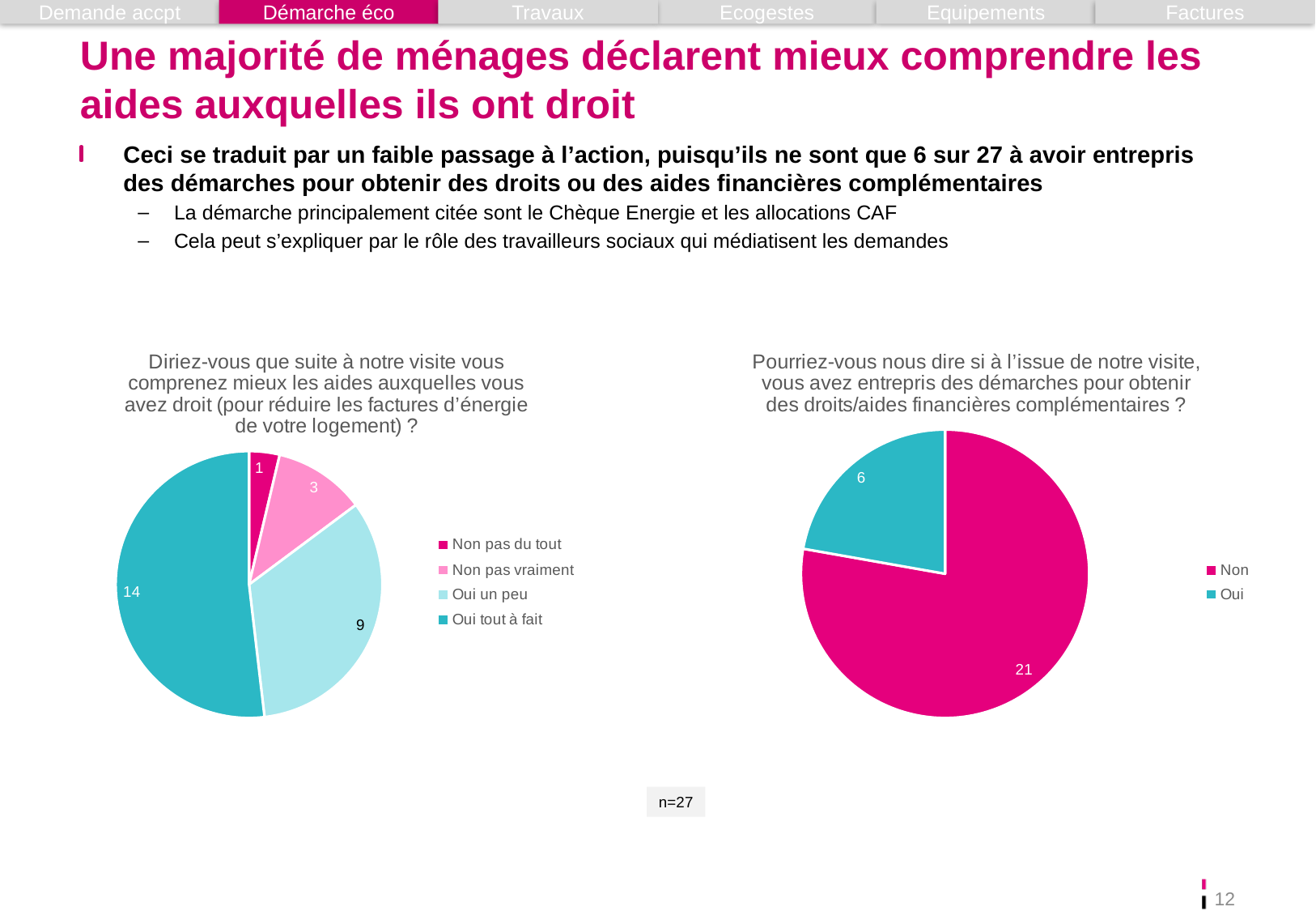
In the right pie chart (Pourriez-vous nous dire si à l'issue de notre visite, vous avez entrepris des démarches...), which is larger, 'Non' or 'Oui'? Non In the left pie chart (Diriez-vous que suite à notre visite vous comprenez mieux les aides...), what is the value for 'Non pas vraiment'? 3 In the right pie chart (Pourriez-vous nous dire si à l'issue de notre visite, vous avez entrepris des démarches...), what is the difference between 'Non' and 'Oui'? 15 In the left pie chart (Diriez-vous que suite à notre visite vous comprenez mieux les aides...), which category has the largest slice? Oui tout à fait In the left pie chart (Diriez-vous que suite à notre visite vous comprenez mieux les aides...), which category has the smallest slice? Non pas du tout In the right pie chart (Pourriez-vous nous dire si à l'issue de notre visite, vous avez entrepris des démarches...), what is the value for 'Non'? 21 What type of chart is used on the right side of the slide (Pourriez-vous nous dire si à l'issue de notre visite...)? Pie chart In the left pie chart (Diriez-vous que suite à notre visite vous comprenez mieux les aides...), how many categories does the legend list? 4 In the right pie chart (Pourriez-vous nous dire si à l'issue de notre visite, vous avez entrepris des démarches...), what is the value for 'Oui'? 6 In the left pie chart (Diriez-vous que suite à notre visite vous comprenez mieux les aides...), what is the difference between 'Oui tout à fait' and 'Oui un peu'? 5 In the left pie chart (Diriez-vous que suite à notre visite vous comprenez mieux les aides...), what is the value for 'Oui tout à fait'? 14 In the left pie chart (Diriez-vous que suite à notre visite vous comprenez mieux les aides...), what is the total of all slices? 27